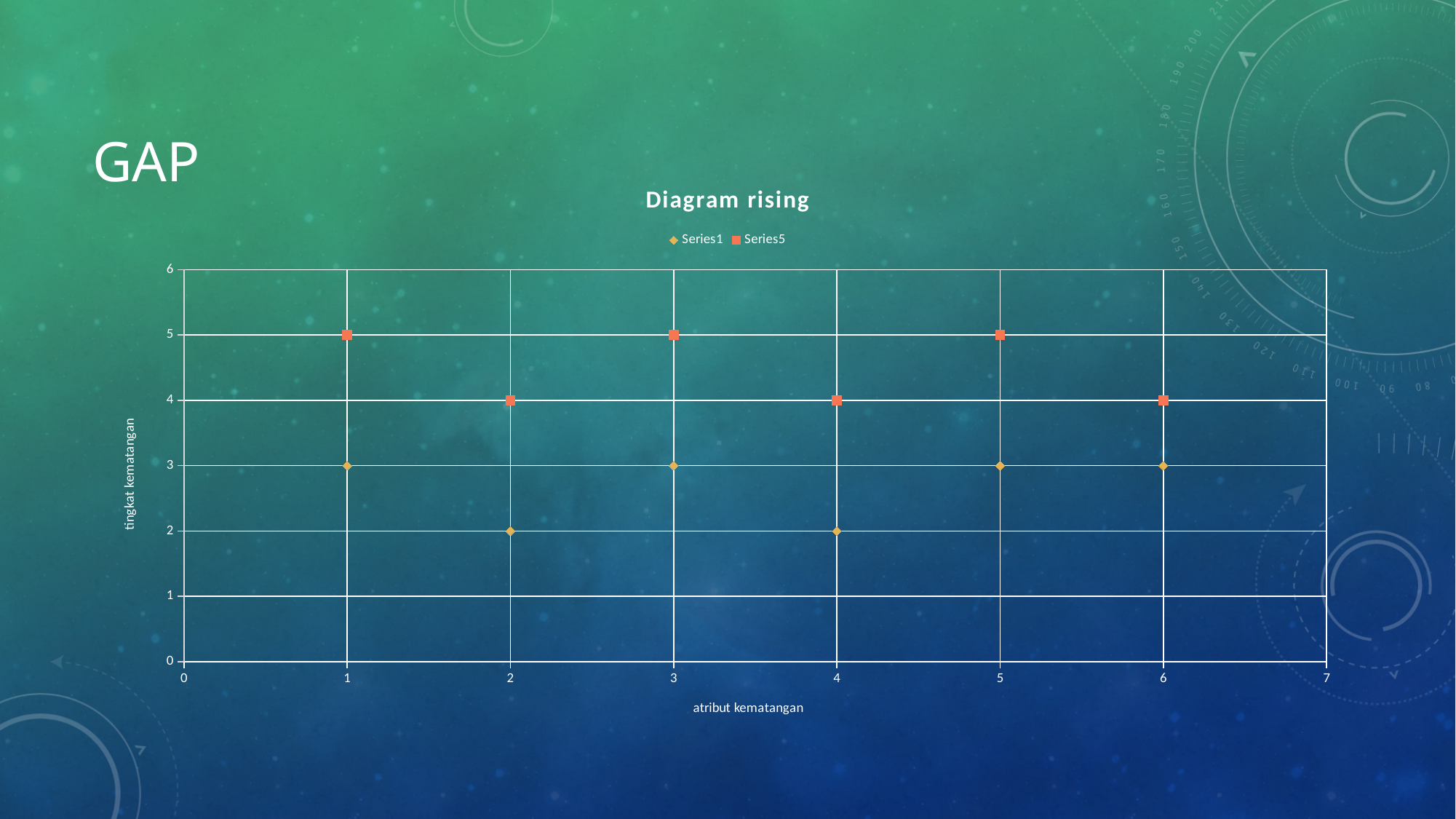
What kind of chart is shown? Scatter chart At x = 4, which series has the larger value, Series1 or Series5? Series5 What is the value of Series5 at x = 6? 4 What is the lowest value plotted for Series5? 4 What is the value of Series5 at x = 1? 5 What is the difference between Series5 and Series1 at x = 3? 2 What is the value of Series1 at x = 5? 3 What is the label of the vertical axis? tingkat kematangan How many data points are plotted for Series1? 6 How many series does the legend list? 2 What is the value of Series1 at x = 2? 2 What is the title of the chart? Diagram rising